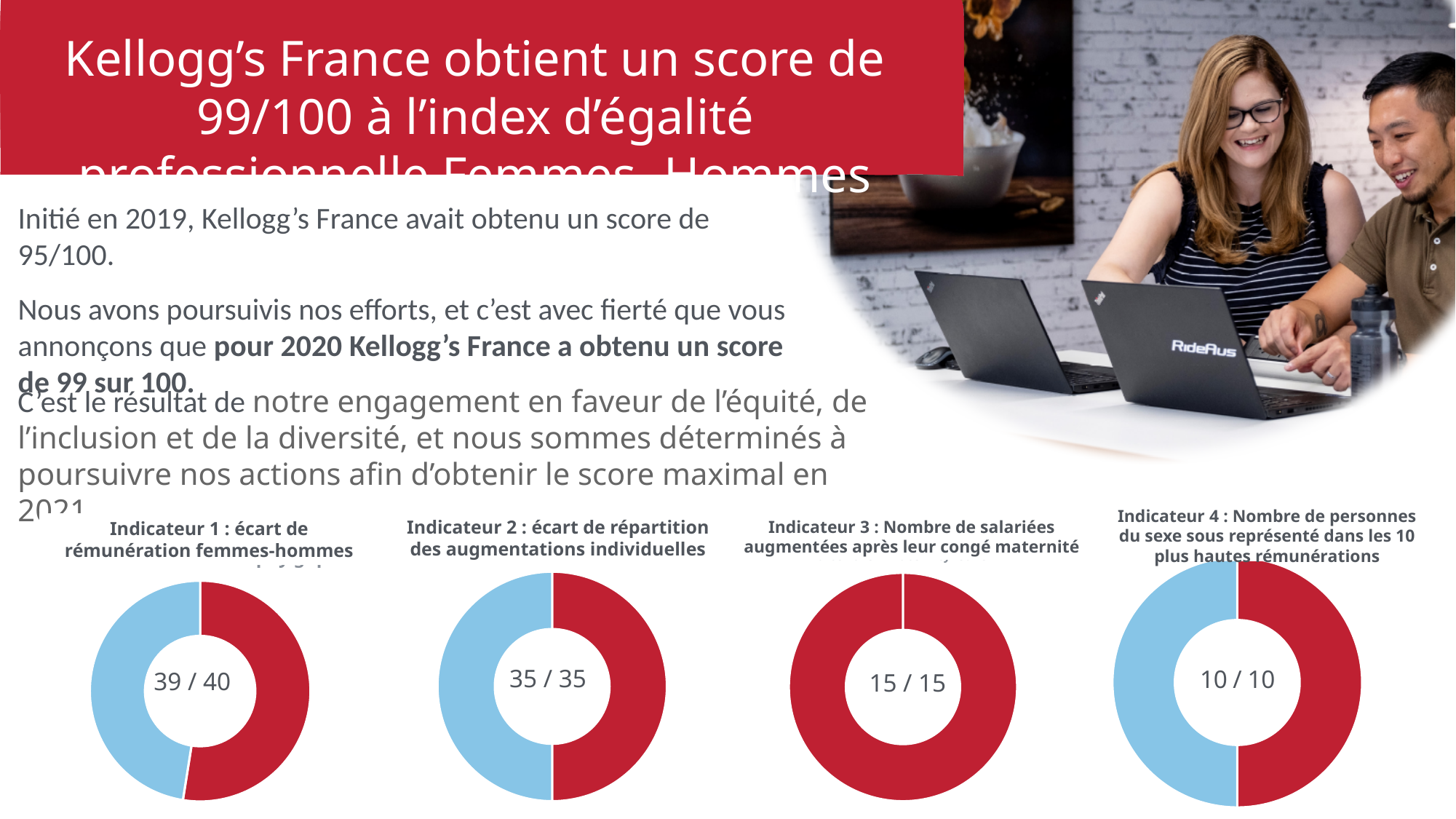
What score is printed in the centre of the chart for Indicateur 3 : Nombre de salariées augmentées après leur congé maternité? 15 / 15 What is the maximum possible score shown for Indicateur 1 : écart de rémunération femmes-hommes? 40 Which indicator's donut chart is filled entirely in red? Indicateur 3 : Nombre de salariées augmentées après leur congé maternité What score is printed in the centre of the chart for Indicateur 1 : écart de rémunération femmes-hommes? 39 / 40 What score is printed in the centre of the chart for Indicateur 2 : écart de répartition des augmentations individuelles? 35 / 35 How many donut charts are shown on the slide? 4 Which indicator chart has the only score that is not the maximum possible? Indicateur 1 : écart de rémunération femmes-hommes What two colours are used in the donut chart for Indicateur 2 : écart de répartition des augmentations individuelles? Red and light blue What kind of chart is used for Indicateur 1 : écart de rémunération femmes-hommes? Donut chart What score is printed in the centre of the chart for Indicateur 4 : Nombre de personnes du sexe sous représenté dans les 10 plus hautes rémunérations? 10 / 10